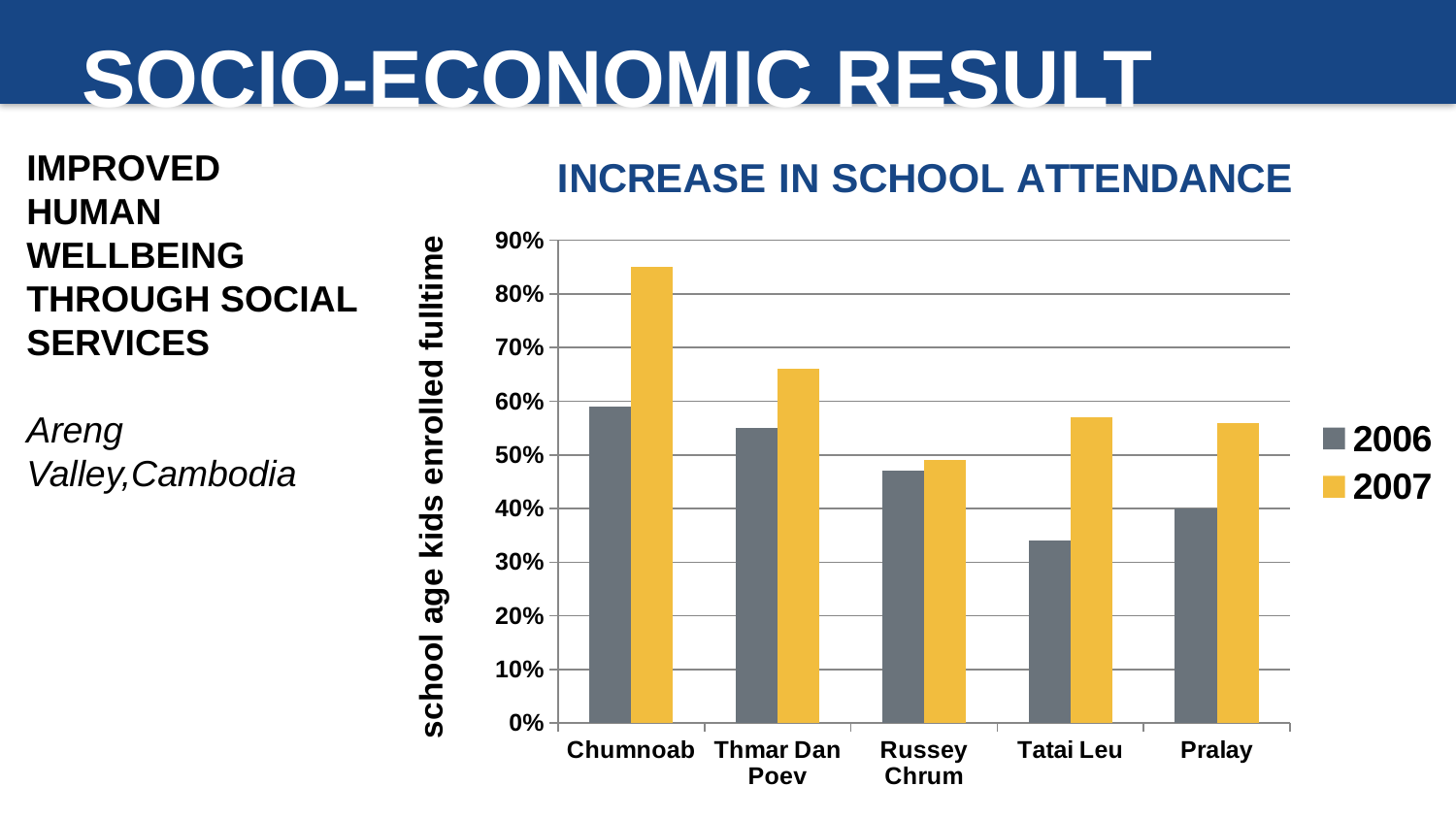
How many series does the legend list? 2 Which is larger, the 2007 value for Chumnoab or the 2007 value for Pralay? Chumnoab Is the 2007 value for Chumnoab greater or less than 80%? greater Is the 2007 value for Thmar Dan Poev greater or less than 60%? greater What is the title of the chart? INCREASE IN SCHOOL ATTENDANCE What type of chart is shown on the slide? bar chart Which village has the lowest 2006 value? Tatai Leu Is the 2006 value for Tatai Leu greater or less than 40%? less Which village has the highest 2007 value? Chumnoab How many villages are shown on the x axis of the chart? 5 What is the label on the vertical axis of the chart? school age kids enrolled fulltime For Tatai Leu, which year has the larger value, 2006 or 2007? 2007